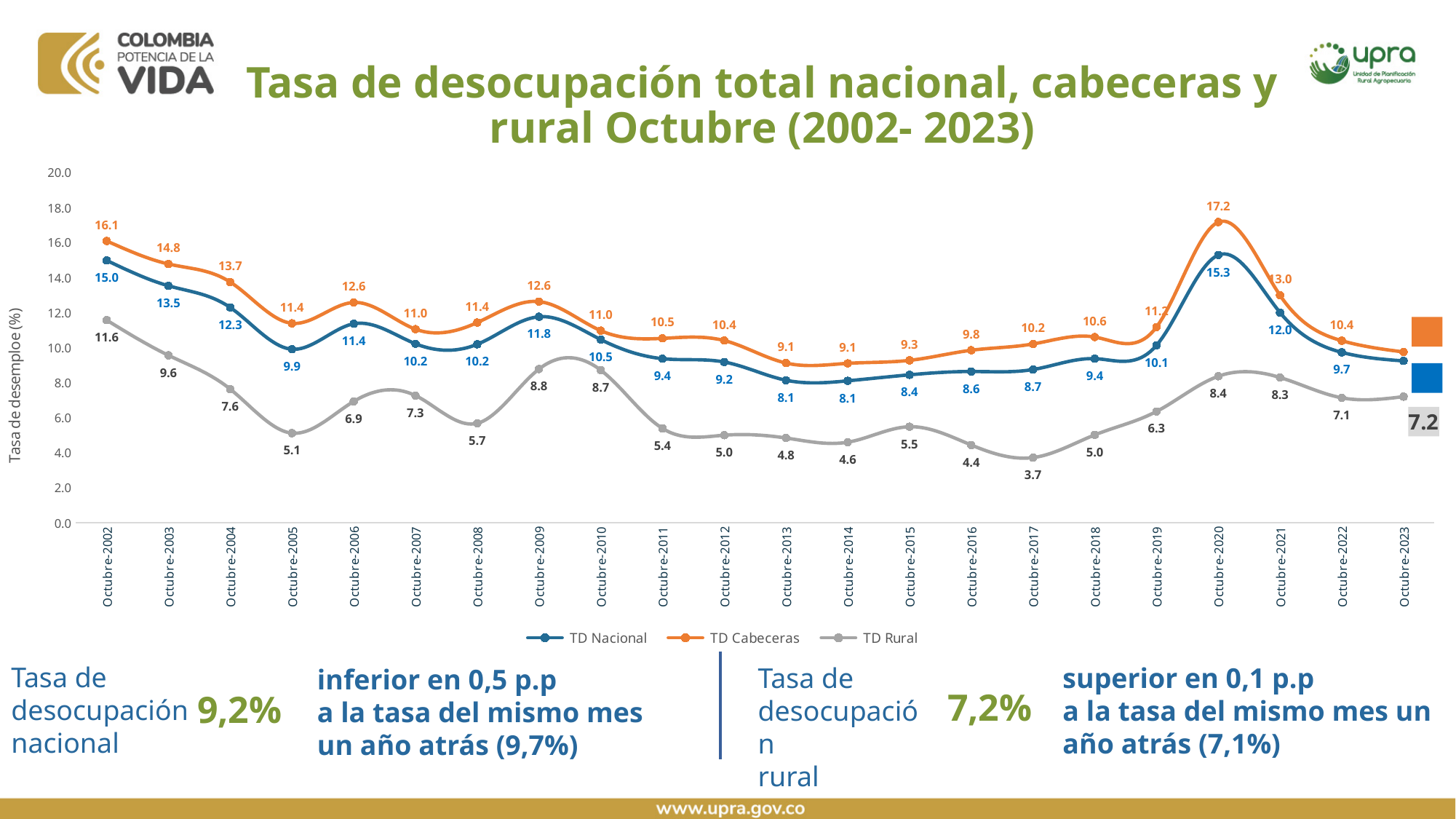
What is the TD Rural value for Octubre-2017? 3.7 In which year does the TD Rural series reach its lowest value? Octubre-2017 In which year does the TD Cabeceras series reach its highest value? Octubre-2020 What is the difference between TD Cabeceras and TD Nacional in Octubre-2020? 1.9 What is the TD Cabeceras value for Octubre-2020? 17.2 Which is larger in Octubre-2002: TD Nacional or TD Rural? TD Nacional How many series does the legend list? 3 What kind of chart is shown on the slide? line chart What is the TD Nacional value for Octubre-2009? 11.8 How many years (data points per series) are shown on the x axis? 22 Is the TD Rural value for Octubre-2005 greater or less than 6.0? less Does the TD Nacional series rise or fall from Octubre-2002 to Octubre-2005? fall